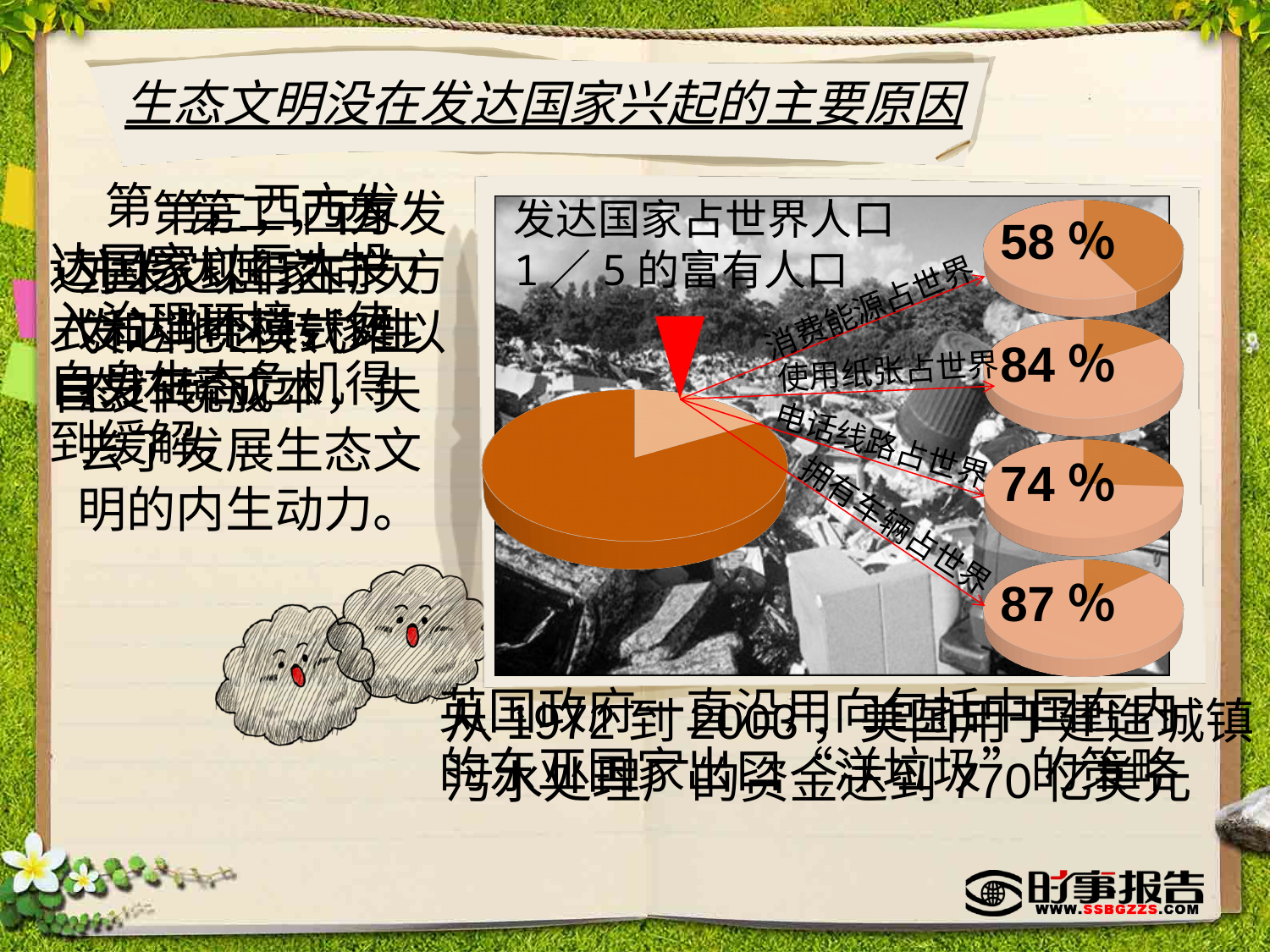
In the small pie chart labelled 消费能源占世界, what percentage is shown? 58 % What kind of chart is the large chart in the centre of the slide? Pie chart In the small pie chart labelled 拥有车辆占世界, what percentage is shown? 87 % What is the difference between the percentage for 使用纸张占世界 and the percentage for 电话线路占世界? 10 percentage points In the small pie chart labelled 电话线路占世界, what percentage is shown? 74 % Among the four small pie charts on the right, which category has the highest percentage? 拥有车辆占世界 Among the four small pie charts on the right, which category has the lowest percentage? 消费能源占世界 In the small pie chart labelled 使用纸张占世界, what percentage is shown? 84 % How many small pie charts are shown on the right side of the large pie chart? 4 What is the difference between the percentage for 拥有车辆占世界 and the percentage for 消费能源占世界? 29 percentage points Which is larger, the percentage for 使用纸张占世界 or the percentage for 电话线路占世界? 使用纸张占世界 According to the label on the large pie chart, what fraction of the world's population do developed countries account for? 1／5